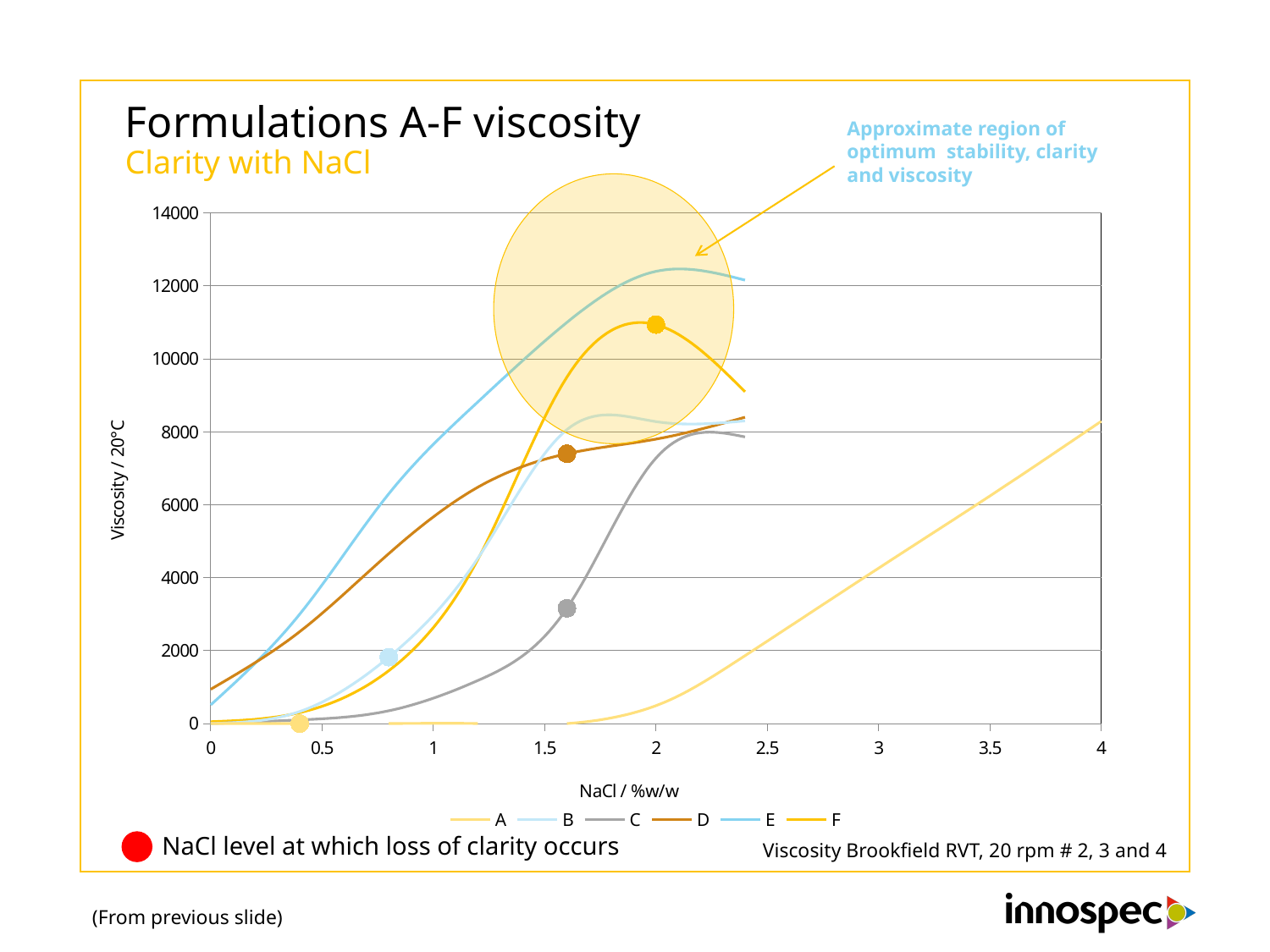
Is the viscosity of series B at NaCl 1.5 %w/w greater or less than 4000? greater At NaCl 1 %w/w, which series has the higher viscosity, E or A? E Is the viscosity of series A at NaCl 2 %w/w greater or less than 2000? less What is the label of the x axis? NaCl / %w/w Is the viscosity of series F at NaCl 2 %w/w greater or less than 10000? greater Does the viscosity of series A rise or fall as NaCl increases from 2 to 4 %w/w? rise What kind of chart is shown on the slide? line chart Which series reaches the highest viscosity on the chart? E Which series has the lowest viscosity at NaCl 1.5 %w/w? A How many series does the legend list? 6 What are the series names listed in the legend? A, B, C, D, E, F